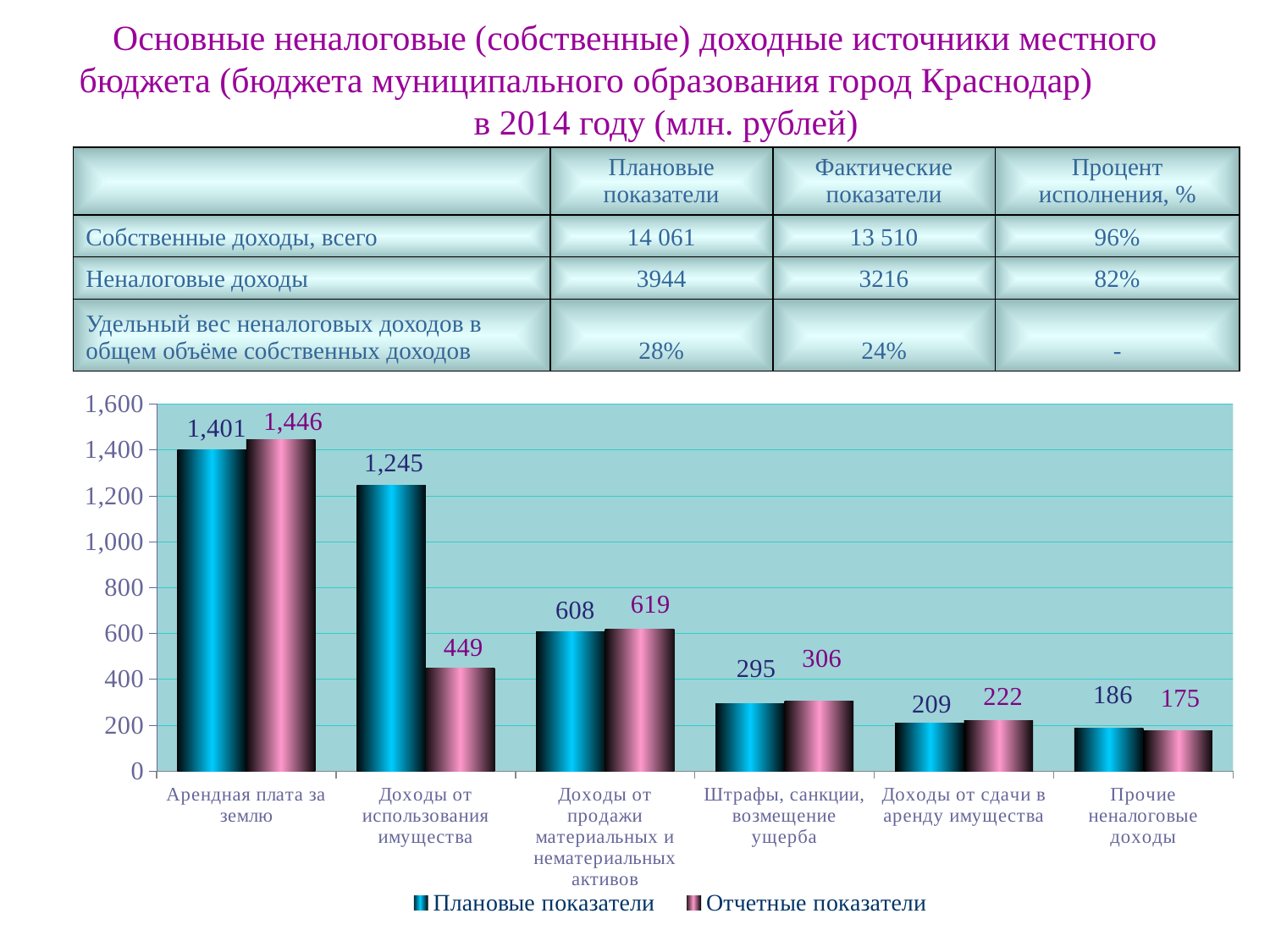
How many categories are shown on the x axis of the chart? 6 What type of chart is shown on the slide? Bar chart For "Прочие неналоговые доходы", which is larger: "Плановые показатели" or "Отчетные показатели"? Плановые показатели What is the value of "Отчетные показатели" for "Штрафы, санкции, возмещение ущерба"? 306 What is the difference between "Плановые показатели" and "Отчетные показатели" for "Доходы от использования имущества"? 796 Is the value of "Плановые показатели" for "Доходы от продажи материальных и нематериальных активов" greater or less than 800? less Which category has the lowest value for "Плановые показатели"? Прочие неналоговые доходы How many series does the chart legend list? 2 What is the second series named in the chart legend? Отчетные показатели What is the value of "Отчетные показатели" for "Арендная плата за землю"? 1,446 What is the value of "Плановые показатели" for "Доходы от использования имущества"? 1,245 Which category has the highest value for "Отчетные показатели"? Арендная плата за землю